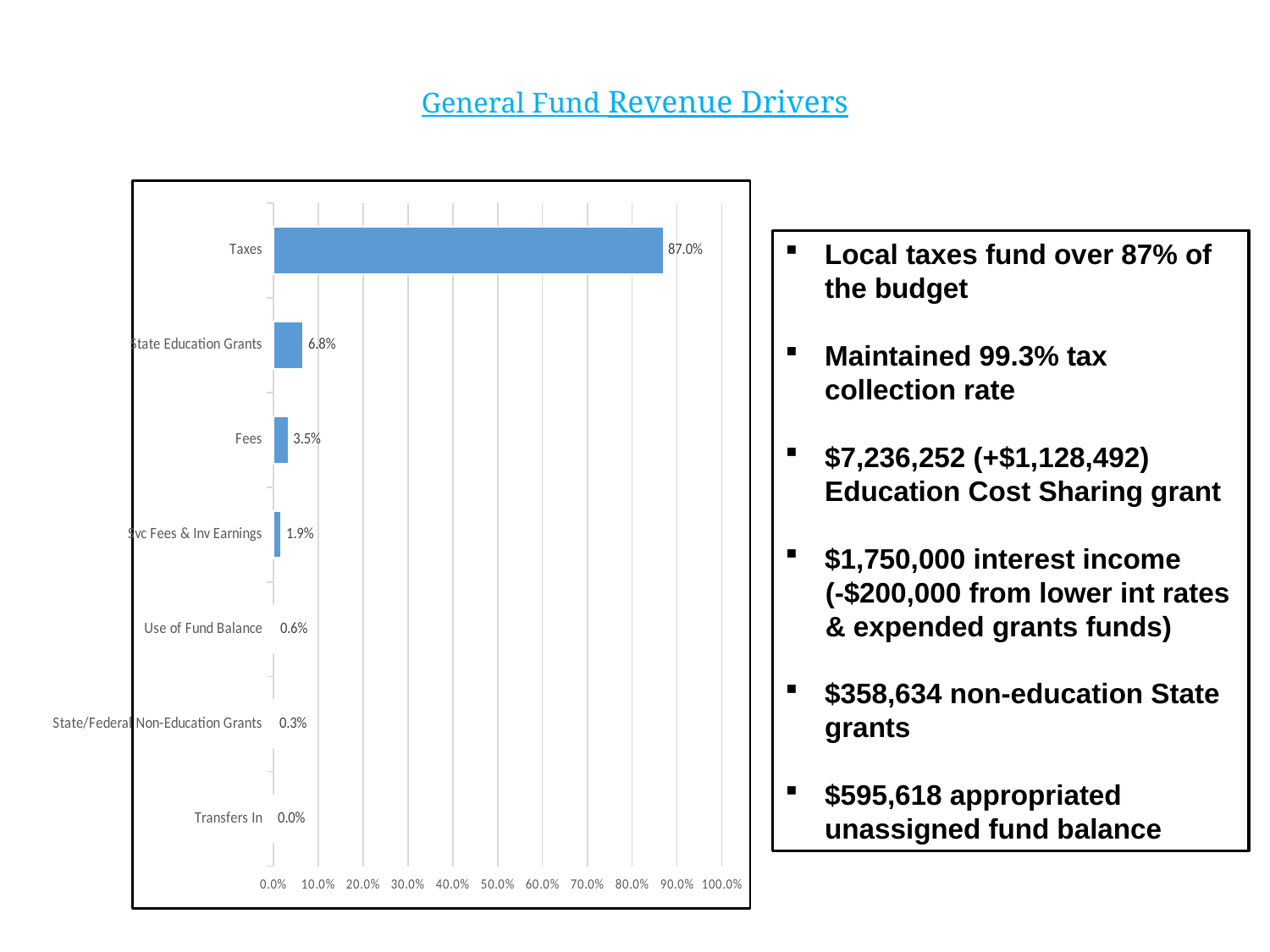
Is the value for Taxes greater or less than 80.0%? greater What is the highest tick value shown on the horizontal axis? 100.0% What is the value for Taxes? 87.0% What kind of chart is shown on the slide? bar chart Which category has the highest value? Taxes How many categories are shown in the chart? 7 What is the difference between the values for Taxes and State Education Grants? 80.2% What is the value for Use of Fund Balance? 0.6% Which is larger, the value for Fees or the value for Svc Fees & Inv Earnings? Fees Which category has the lowest value? Transfers In What is the value for Fees? 3.5% What is the value for Transfers In? 0.0%